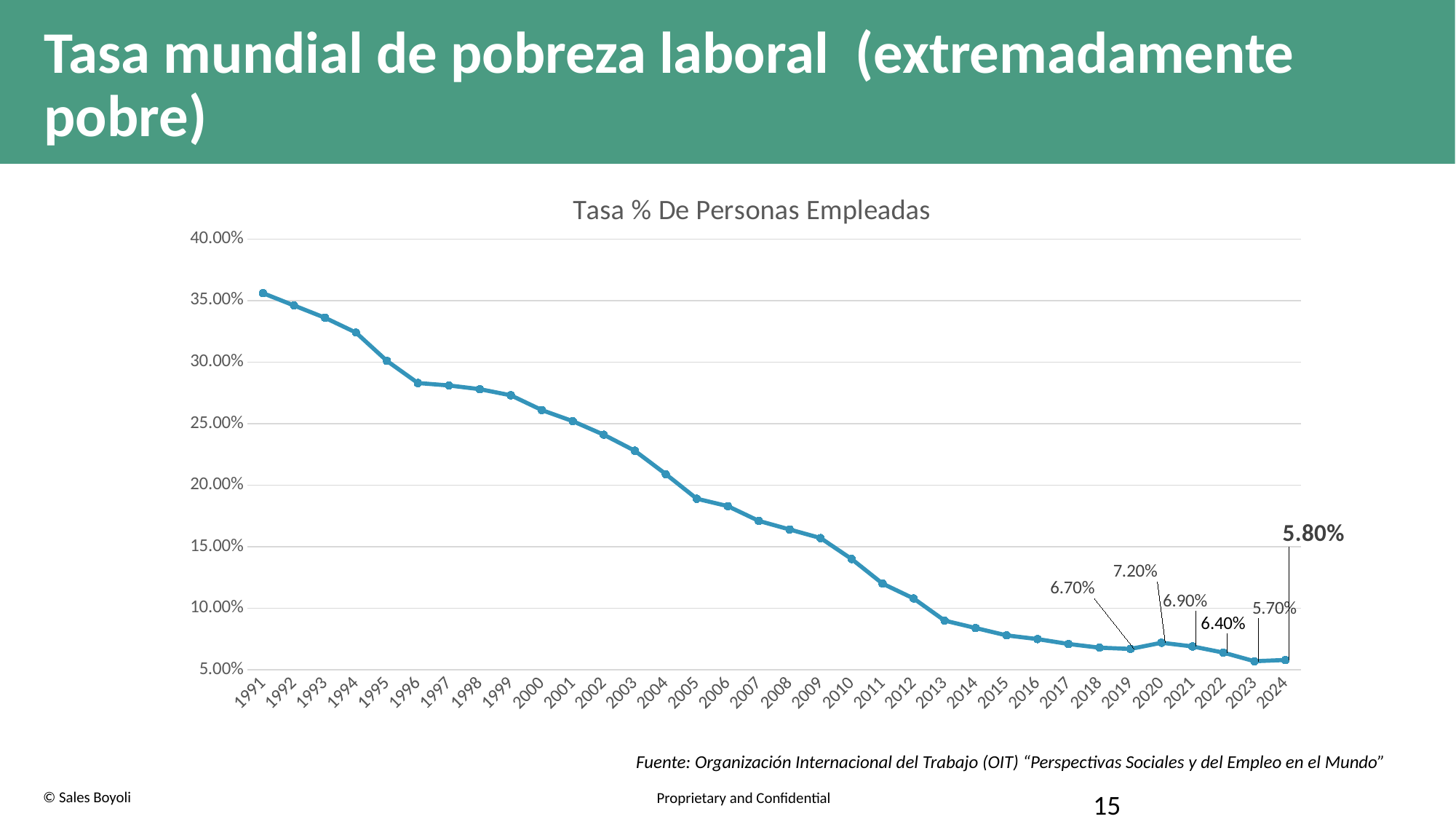
What is the value for 2022? 6.40% Is the value for 1995 greater or less than 25.00%? greater What is the value for 2020? 7.20% What type of chart is shown on the slide? line chart Which is larger, the value for 2021 or the value for 2022? 2021 What is the value for 2019? 6.70% Does the value generally rise or fall from 1991 to 2024? fall Which year has the highest value? 1991 Which year has the lowest value? 2023 What is the chart's title? Tasa % De Personas Empleadas What is the value for 2024? 5.80% What is the difference between the values for 2020 and 2023? 1.50%